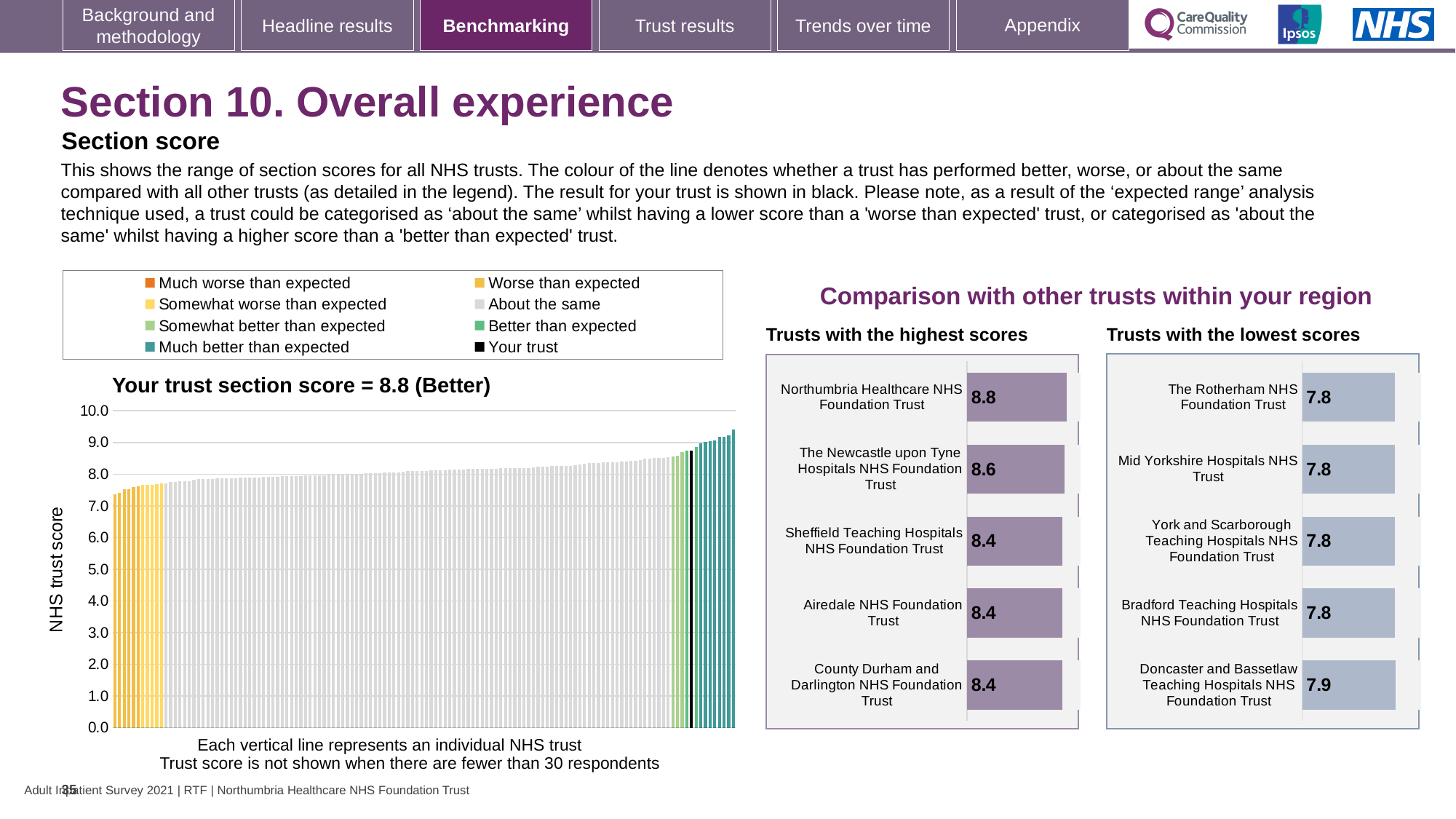
What kind of chart is the 'Your trust section score' chart? bar chart In the 'Trusts with the lowest scores' chart, which is larger: the score for Doncaster and Bassetlaw Teaching Hospitals NHS Foundation Trust or the score for The Rotherham NHS Foundation Trust? Doncaster and Bassetlaw Teaching Hospitals NHS Foundation Trust In the 'Your trust section score' chart, what is the section score for your trust? 8.8 In the 'Your trust section score' chart, is the value of the highest bar greater or less than 10.0? less In the 'Your trust section score' chart, do the bars rise or fall from left to right? rise How many entries does the legend above the 'Your trust section score' chart list? 8 How many trusts are shown in the 'Trusts with the lowest scores' chart? 5 In the 'Trusts with the highest scores' chart, what is the score for The Newcastle upon Tyne Hospitals NHS Foundation Trust? 8.6 In the 'Trusts with the highest scores' chart, what is the difference between the scores of Northumbria Healthcare NHS Foundation Trust and The Newcastle upon Tyne Hospitals NHS Foundation Trust? 0.2 In the 'Your trust section score' chart, is the value of the lowest bar greater or less than 7.0? greater What is the label on the vertical axis of the 'Your trust section score' chart? NHS trust score In the 'Trusts with the highest scores' chart, which trust has the highest score? Northumbria Healthcare NHS Foundation Trust